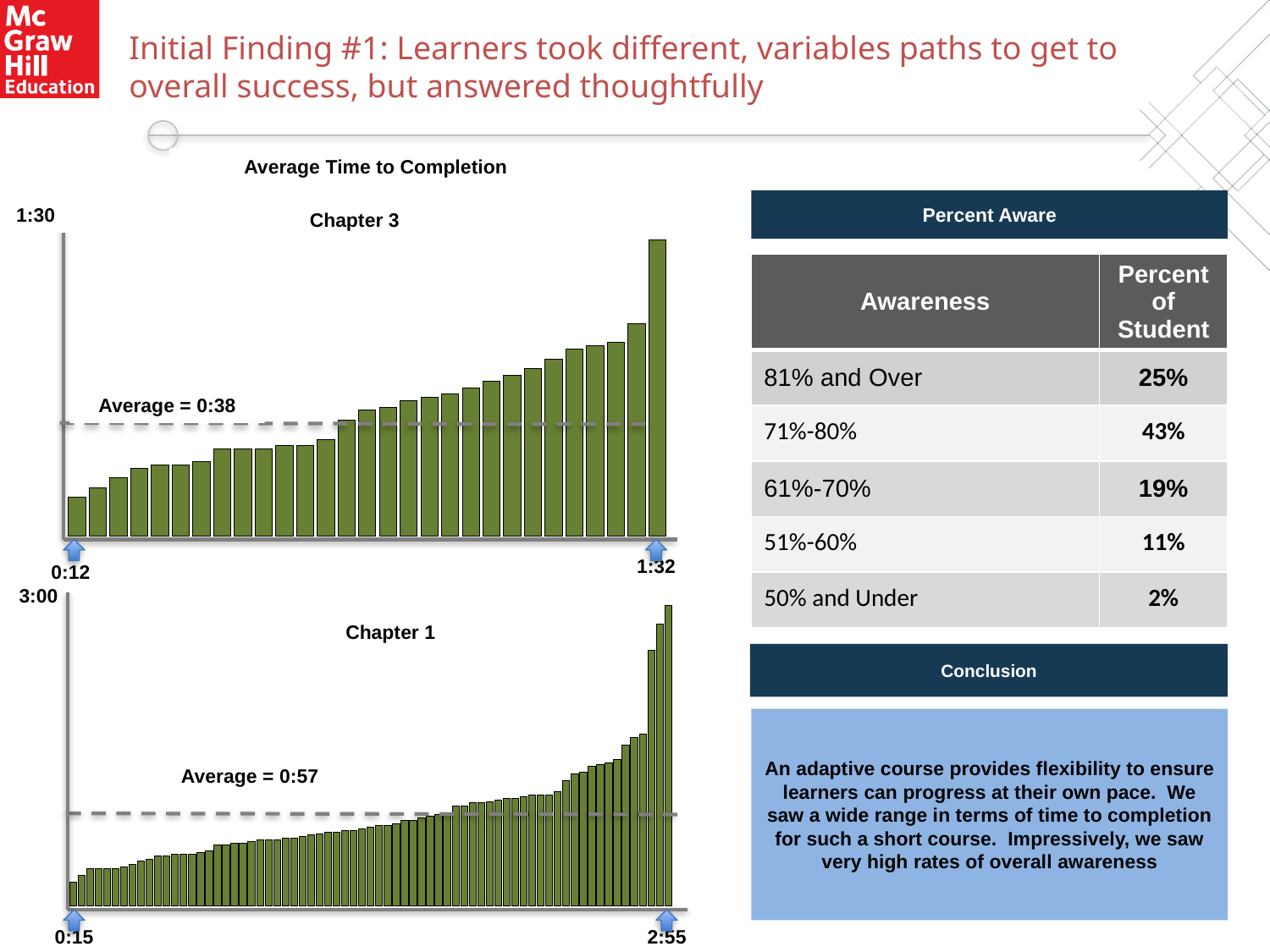
In the Chapter 3 chart, what is the longest time to completion labelled? 1:32 In the Chapter 1 chart, what is the longest time to completion labelled? 2:55 What kind of chart is the Chapter 3 chart? bar chart In the Chapter 1 chart, what is the average time to completion shown? 0:57 In the Chapter 3 chart, what is the difference between the longest time (1:32) and the shortest time (0:12)? 1:20 In the Chapter 1 chart, do the bars rise or fall from left to right? rise In the Chapter 1 chart, what is the shortest time to completion labelled? 0:15 What is the difference between the Chapter 1 average (0:57) and the Chapter 3 average (0:38)? 0:19 Which chapter has the higher average time to completion, Chapter 1 or Chapter 3? Chapter 1 In the Chapter 3 chart, what is the shortest time to completion labelled? 0:12 In the Chapter 3 chart, what is the average time to completion shown? 0:38 What is the title shown above the two bar charts? Average Time to Completion